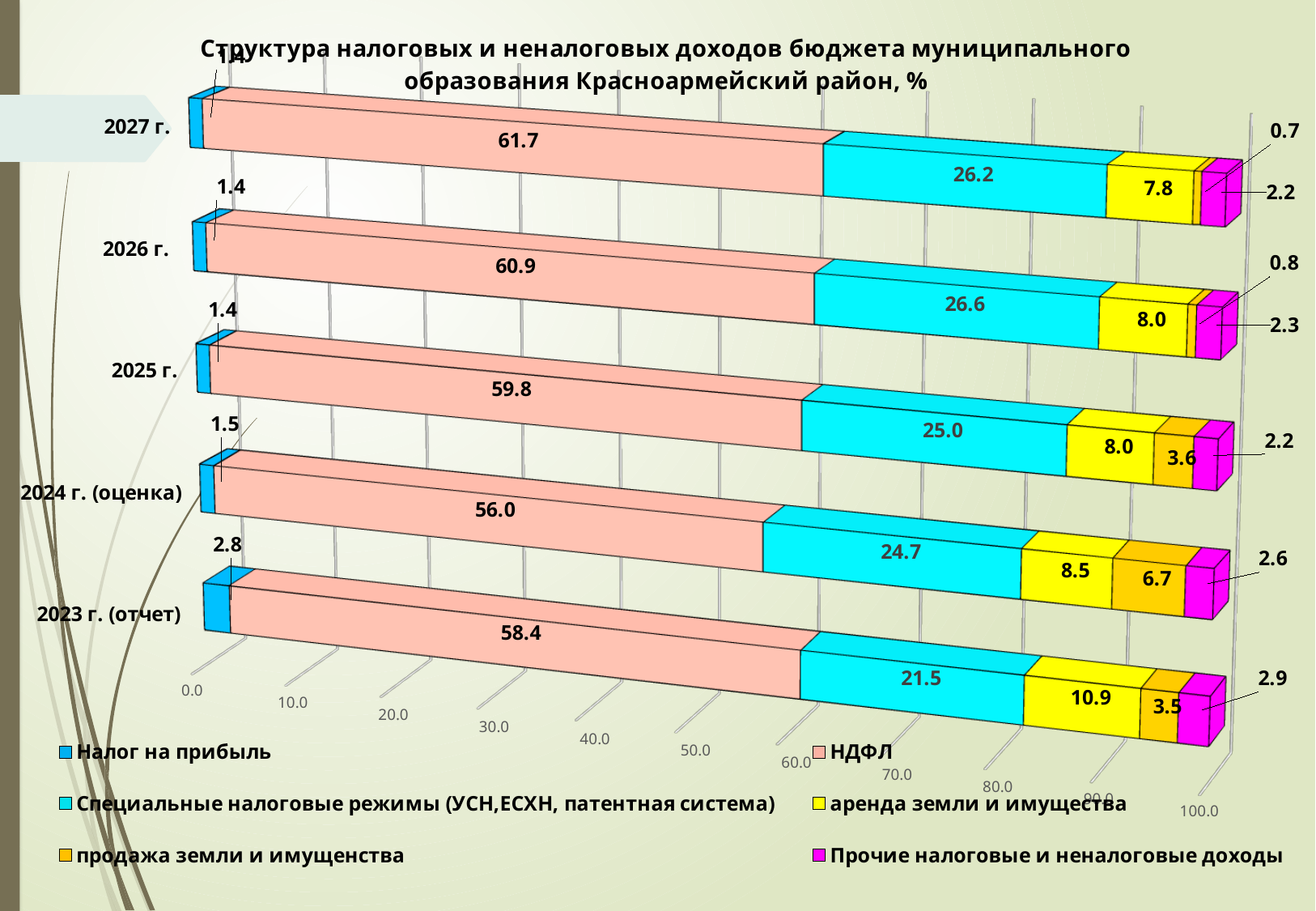
What is the value of аренда земли и имущества for 2023 г. (отчет)? 10.9 What is the difference between the НДФЛ values for 2027 г. and 2024 г. (оценка)? 5.7 What kind of chart is shown on the slide? Stacked bar chart Which is larger: аренда земли и имущества for 2023 г. (отчет) or for 2024 г. (оценка)? 2023 г. (отчет) Which year has the lowest value for продажа земли и имущенства? 2027 г. Which year has the highest value for НДФЛ? 2027 г. What is the value of Специальные налоговые режимы (УСН,ЕСХН, патентная система) for 2023 г. (отчет)? 21.5 What is the value of Прочие налоговые и неналоговые доходы for 2026 г.? 2.3 How many series does the legend list? 6 What is the value of продажа земли и имущенства for 2024 г. (оценка)? 6.7 How many years (categories) are shown on the chart? 5 What is the value of НДФЛ for 2027 г.? 61.7